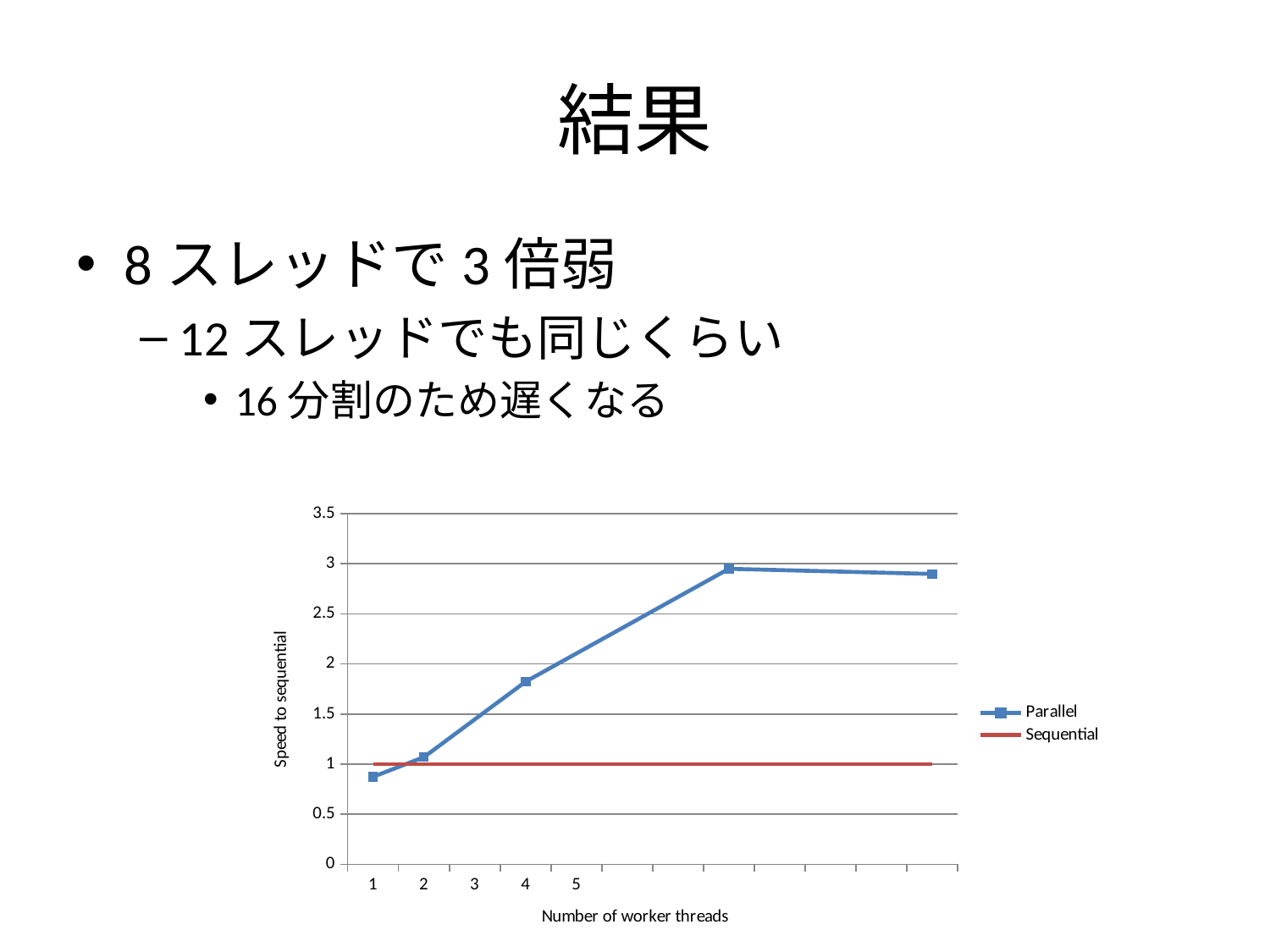
How many data points are marked on the Parallel line? 5 Does the Parallel line rise or fall between 1 and 4 worker threads? rise Is the Parallel value at 4 worker threads greater or less than 1.5? greater Which series is drawn in red on the chart? Sequential At 4 worker threads, which series has the larger value, Parallel or Sequential? Parallel What are the two series named in the chart legend? Parallel and Sequential What is the title of the chart's y axis? Speed to sequential How many series does the chart legend list? 2 Is the highest Parallel value on the chart greater or less than 3? less What value does the Sequential line sit at across the chart? 1 Is the Parallel value at 1 worker thread greater or less than 1? less What type of chart is shown on the slide? Line chart